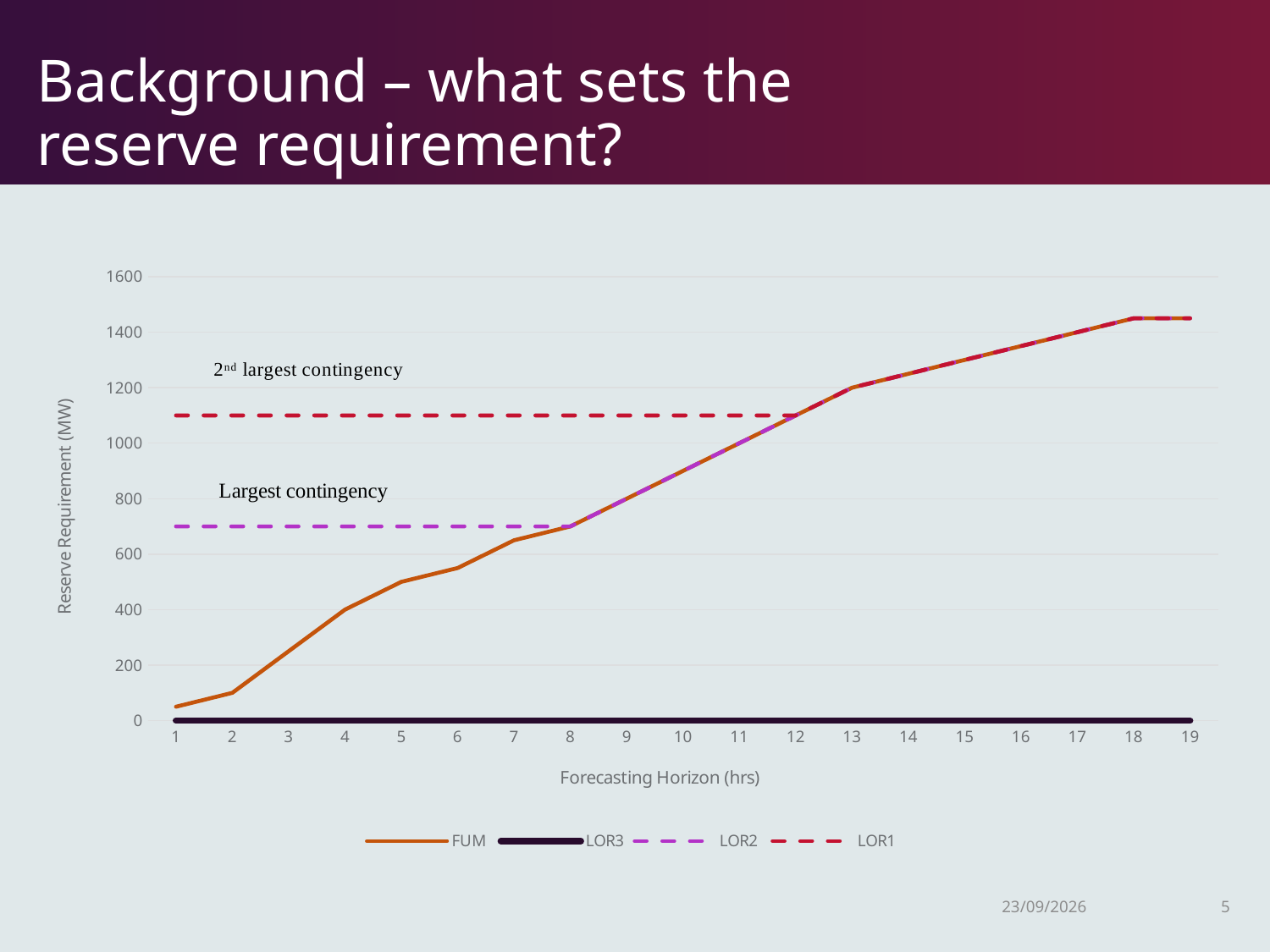
How many series does the legend list? 4 Is the FUM value at a forecasting horizon of 5 hrs greater or less than 600? less At a forecasting horizon of 5 hrs, which is larger, LOR1 or LOR2? LOR1 Is the LOR1 value at a forecasting horizon of 3 hrs greater or less than 1000? greater Is the LOR2 value at a forecasting horizon of 3 hrs greater or less than 800? less Which series has the lowest value at a forecasting horizon of 10 hrs? LOR3 How many forecasting horizon points are shown on the x axis? 19 What kind of chart is shown on the slide? line chart What is the title of the x axis? Forecasting Horizon (hrs) Does the FUM series rise or fall as the forecasting horizon increases? rises